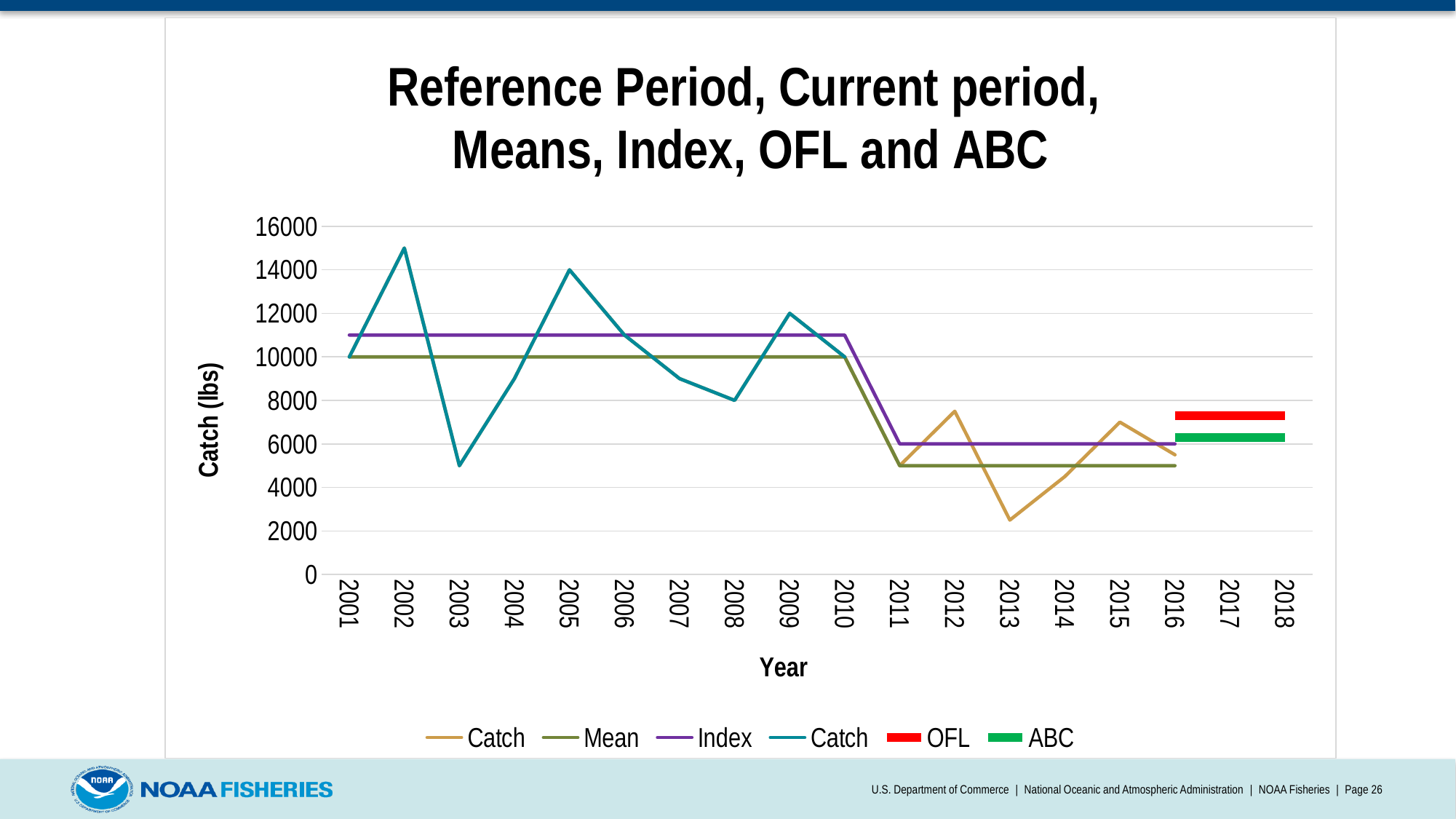
How many series does the legend list? 6 Is the catch in 2002 greater or less than 14000? greater Is the OFL value greater or less than 6000? greater What kind of chart is shown on the slide? line chart Which year has the larger catch, 2012 or 2014? 2012 What is the label of the y axis? Catch (lbs) What is the catch value in 2008? 8000 In which year is the catch lowest? 2013 What is the value of the Mean line in 2001? 10000 How many years are shown on the x axis? 18 In which year is the catch highest? 2002 Is the catch in 2013 greater or less than 4000? less